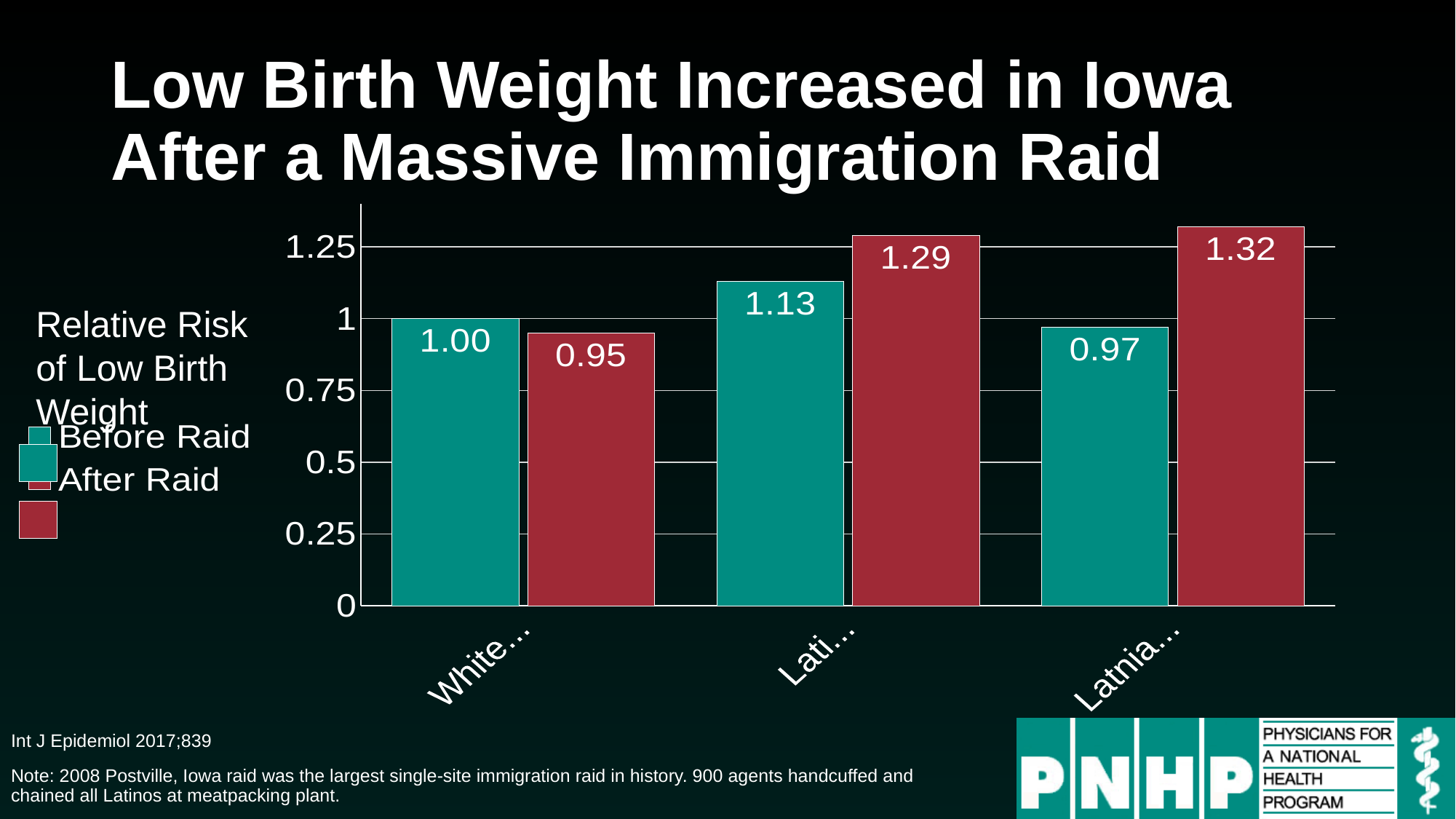
How many category groups are plotted on the x axis? 3 What are the two legend entries of the chart? Before Raid, After Raid In the third category group, what is the difference between the After Raid and Before Raid values? 0.35 Which category group has the highest After Raid value? the third group (Latnia…) In the second category group, what is the difference between the After Raid and Before Raid values? 0.16 How many series does the legend list? 2 In the first category group, which is larger: the Before Raid value or the After Raid value? Before Raid What is the After Raid value for the second category group (labelled 'Lati…')? 1.29 What is the After Raid value for the third category group (labelled 'Latnia…')? 1.32 What kind of chart is shown on the slide? bar chart Which bar has the lowest value in the chart? After Raid in the first group (0.95) What is the Before Raid value for the first category group (labelled 'White…')? 1.00